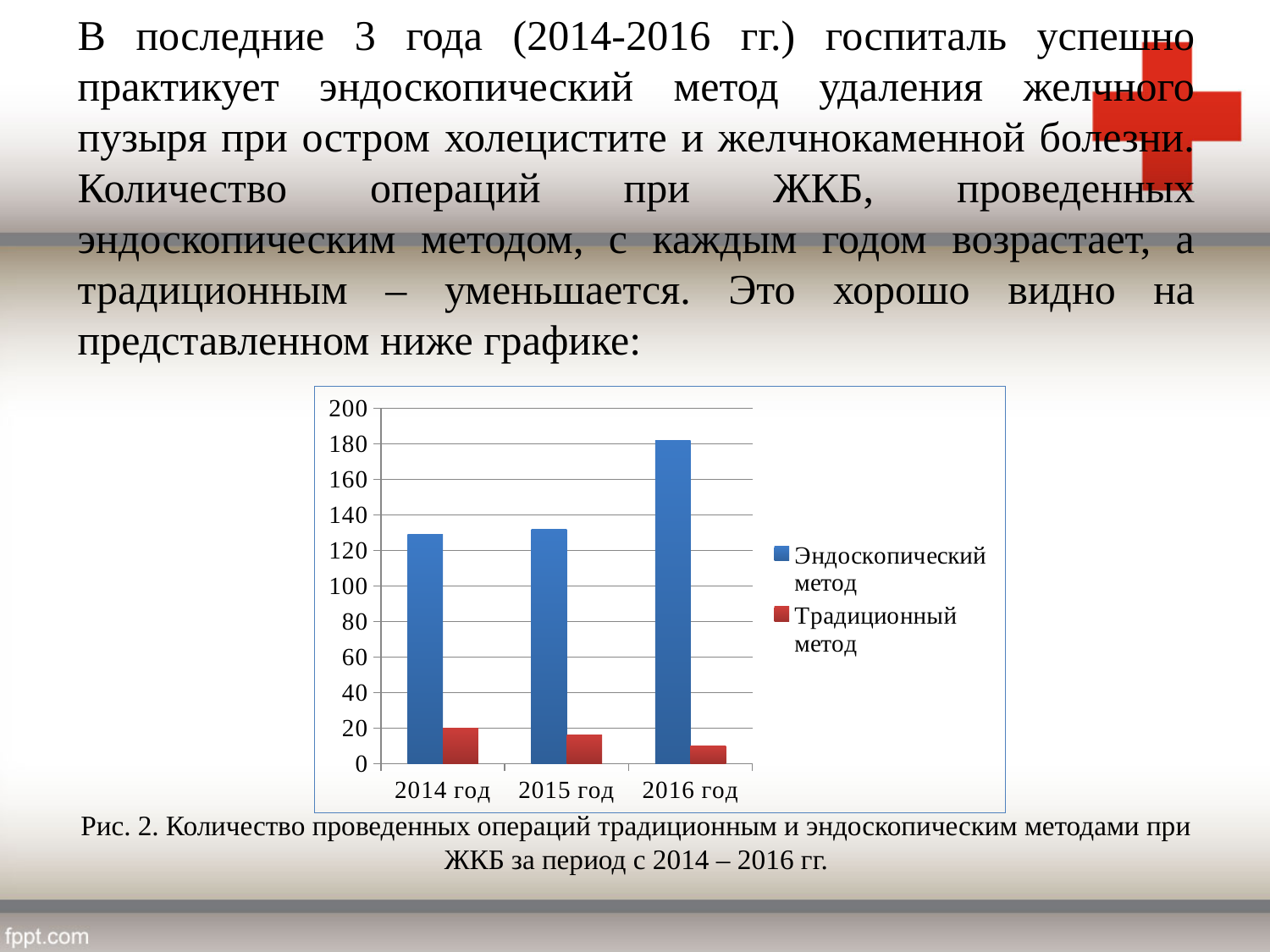
Is the value for Эндоскопический метод in 2014 год greater or less than 100? greater Do the values for Традиционный метод rise or fall from 2014 год to 2016 год? fall How many year categories are shown on the x axis? 3 How many series does the legend list? 2 Which year has the lowest value for Традиционный метод? 2016 год Which year has the highest value for Эндоскопический метод? 2016 год What colour are the bars for Эндоскопический метод? blue Is the value for Традиционный метод in 2016 год greater or less than 20? less Is the value for Эндоскопический метод in 2016 год greater or less than 160? greater What kind of chart is shown on the slide? bar chart Which is larger: Традиционный метод in 2014 год or Традиционный метод in 2016 год? 2014 год